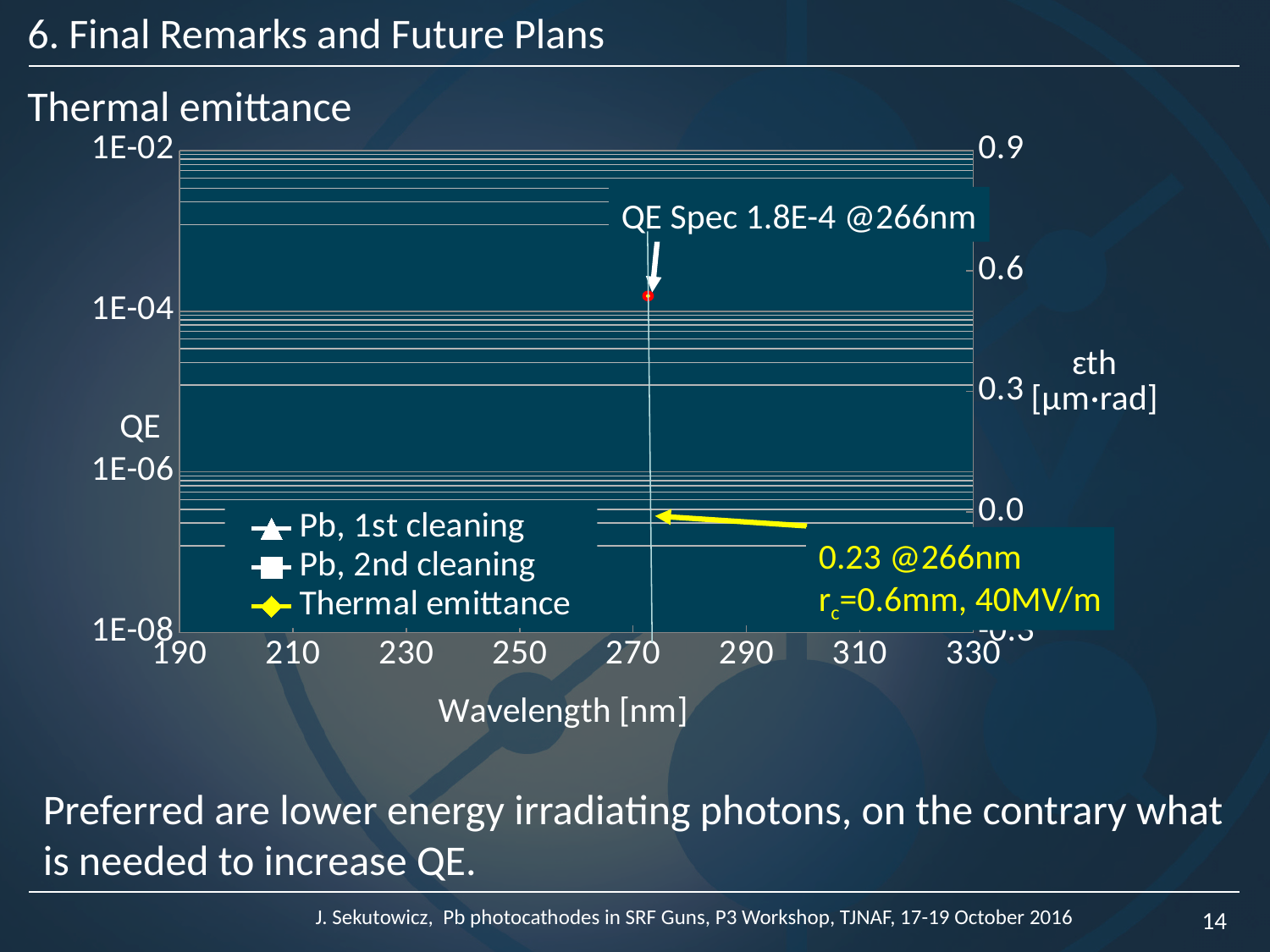
What unit is given for the right-hand εth axis? [μm·rad] What is the bottom tick value on the left QE axis? 1E-08 What is the lowest wavelength tick shown on the x axis? 190 What is the title of the chart? Thermal emittance What thermal emittance value is annotated on the chart at 266 nm? 0.23 What is the QE specification value annotated on the chart at 266 nm? 1.8E-4 What is the highest wavelength tick shown on the x axis? 330 What is the top tick value on the left QE axis? 1E-02 What quantity is plotted on the x axis of the chart? Wavelength [nm] What are the three series named in the chart legend? Pb, 1st cleaning; Pb, 2nd cleaning; Thermal emittance How many series does the chart legend list? 3 What is the highest tick value on the right εth axis? 0.9